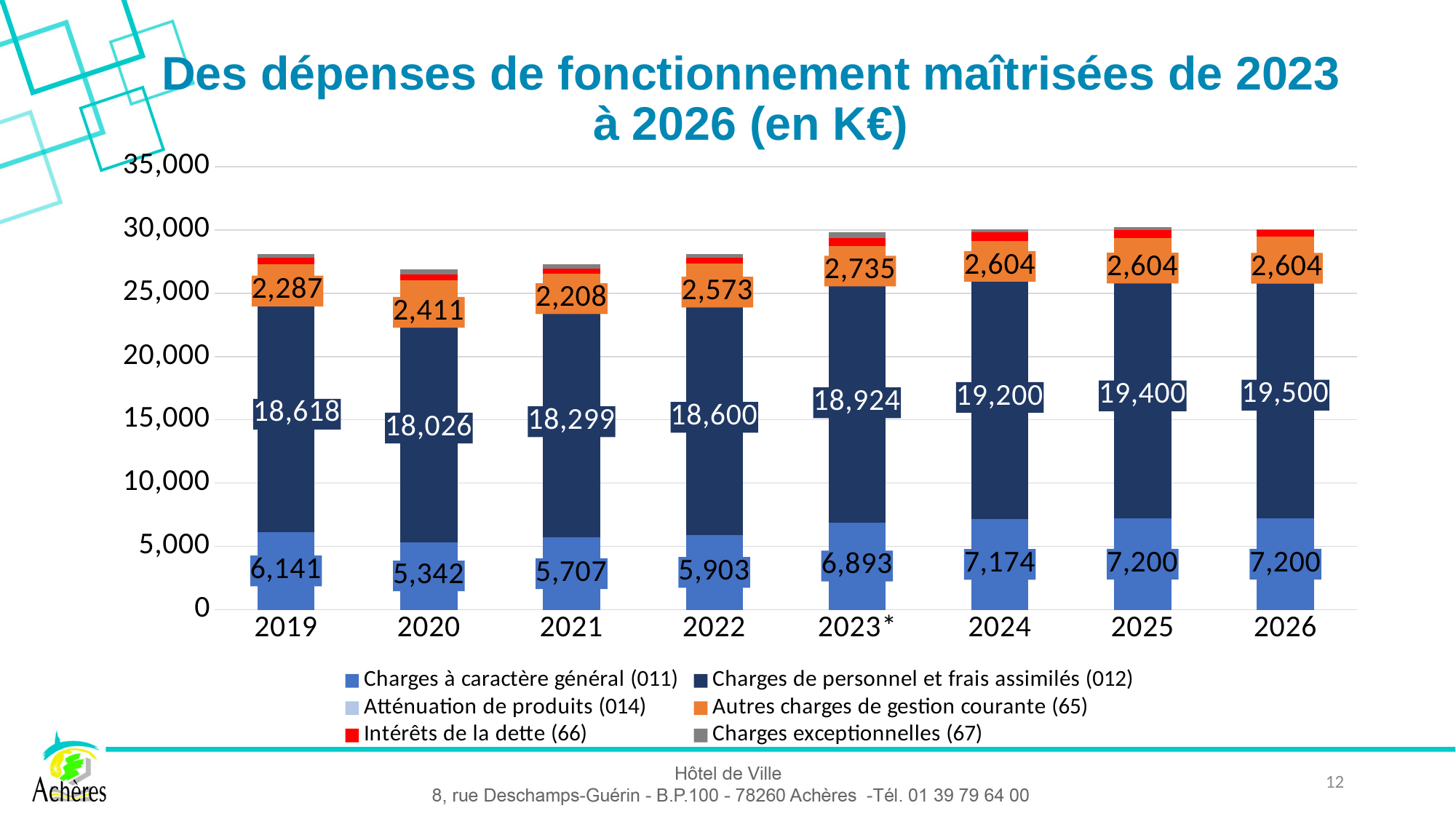
Which is larger: Autres charges de gestion courante (65) in 2023* or in 2024? 2023* What is the value of Autres charges de gestion courante (65) in 2022? 2,573 What is the value of Charges à caractère général (011) in 2020? 5,342 In which year is Charges de personnel et frais assimilés (012) the highest? 2026 How many series does the legend list? 6 What is the difference between Charges de personnel et frais assimilés (012) in 2026 and in 2019? 882 What colour represents Intérêts de la dette (66) in the legend? red In which year is Charges à caractère général (011) the lowest? 2020 How many years are shown on the x axis? 8 Does Charges de personnel et frais assimilés (012) rise or fall from 2020 to 2026? rise What is the value of Charges de personnel et frais assimilés (012) in 2023*? 18,924 What type of chart is shown on the slide? stacked bar chart